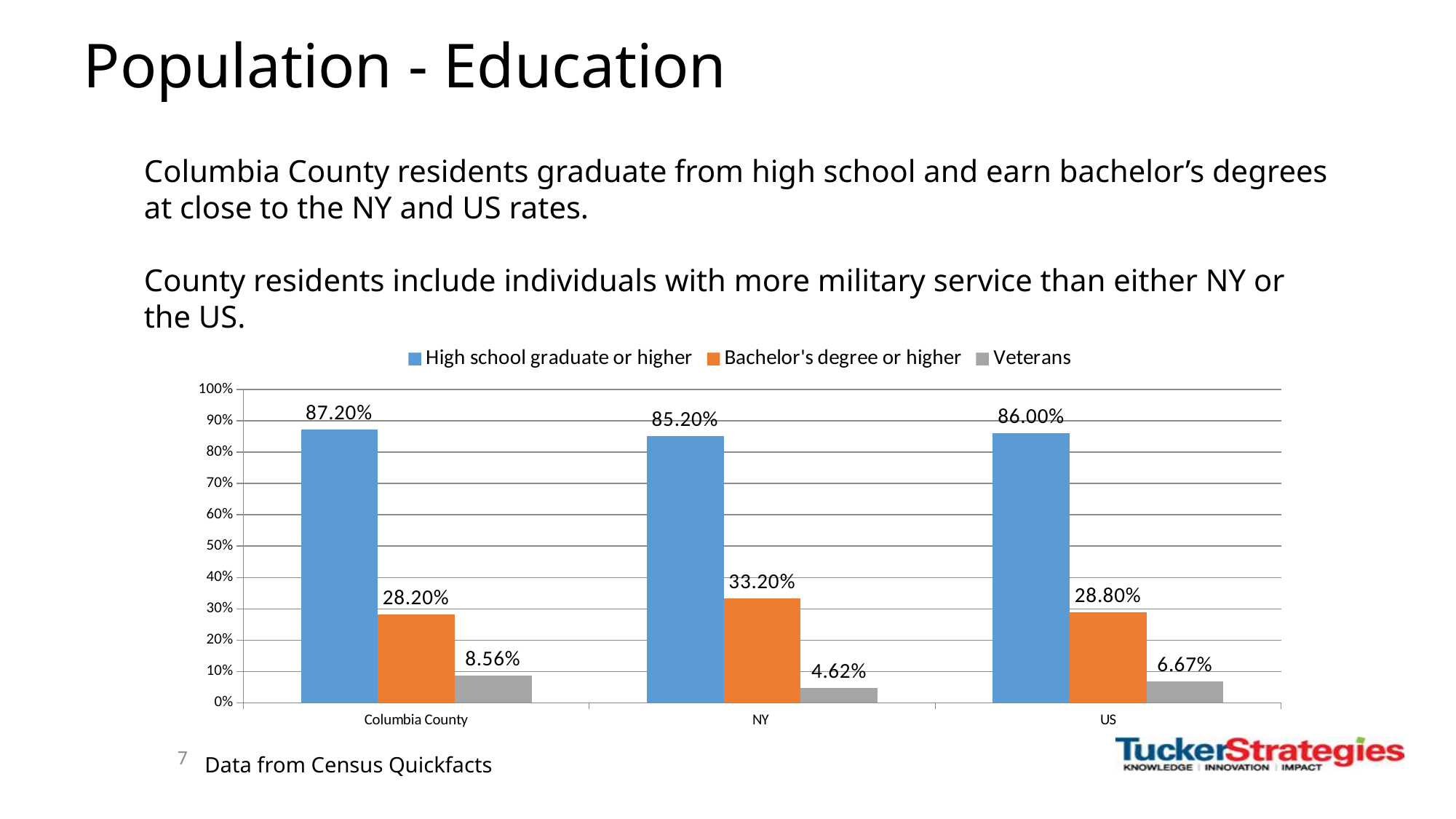
Is the value for Bachelor's degree or higher in the US greater or less than 30%? less What is the value for High school graduate or higher in Columbia County? 87.20% Which is larger, the Veterans value for NY or for the US? US What is the difference between the Bachelor's degree or higher values for NY and Columbia County? 5.00% How many categories are shown on the x axis? 3 Which category has the lowest value for High school graduate or higher? NY Which colour represents the Veterans series? Gray How many series does the legend list? 3 What kind of chart is shown on the slide? Bar chart Which category has the highest value for Veterans? Columbia County What is the value for Veterans in the US? 6.67% What is the value for Bachelor's degree or higher in NY? 33.20%